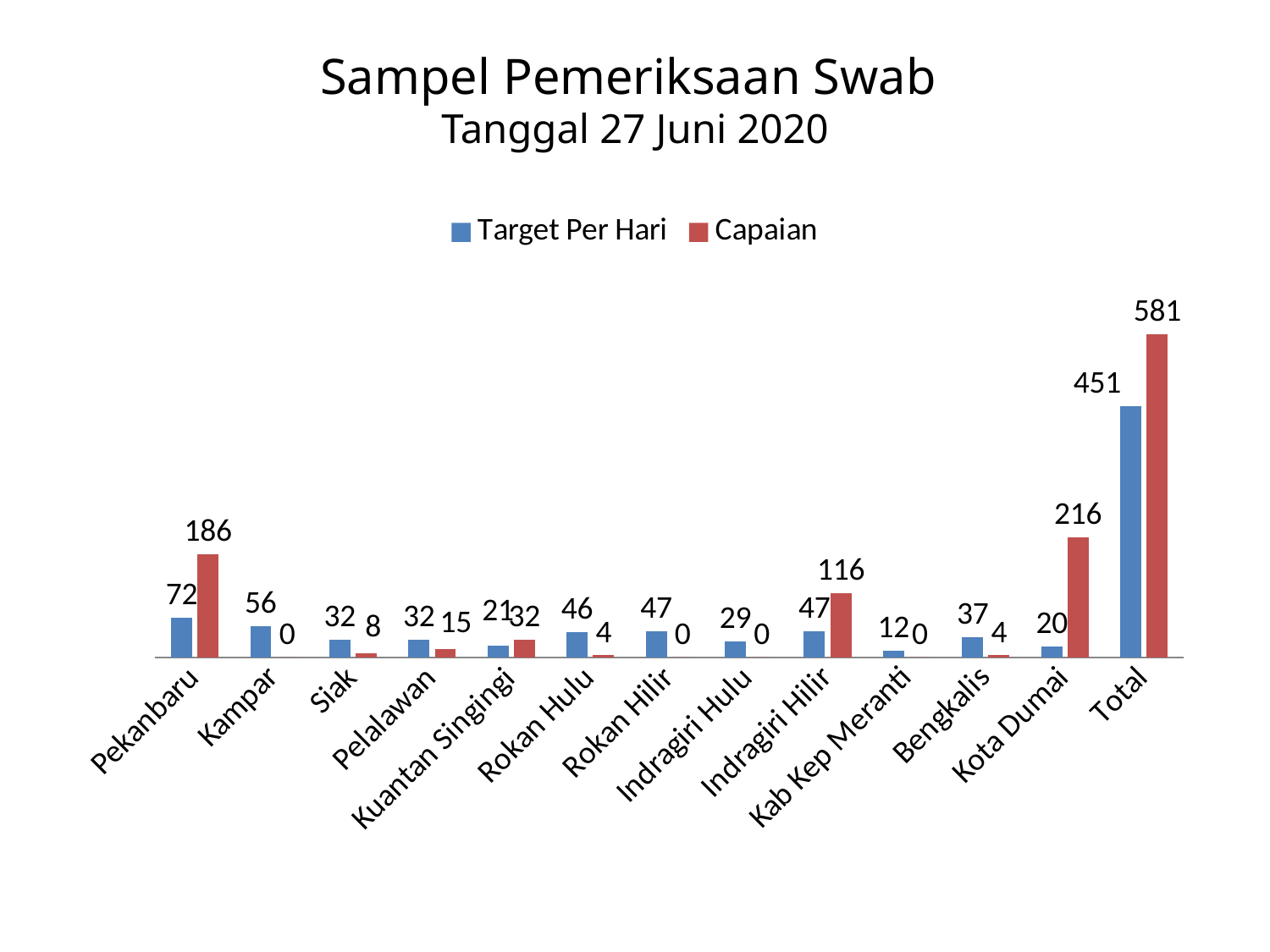
What is the title of the chart? Sampel Pemeriksaan Swab Tanggal 27 Juni 2020 Excluding Total, which category has the lowest Target Per Hari value? Kab Kep Meranti What is the Capaian value for Kota Dumai? 216 What is the Target Per Hari value for Total? 451 What is the difference between the Capaian and Target Per Hari values for Indragiri Hilir? 69 What is the Target Per Hari value for Kampar? 56 What is the Capaian value for Pekanbaru? 186 Which is larger for Rokan Hulu, Target Per Hari or Capaian? Target Per Hari What kind of chart is shown on the slide? Bar chart Excluding Total, which category has the highest Capaian value? Kota Dumai How many categories are shown on the x axis? 13 How many series does the legend list? 2